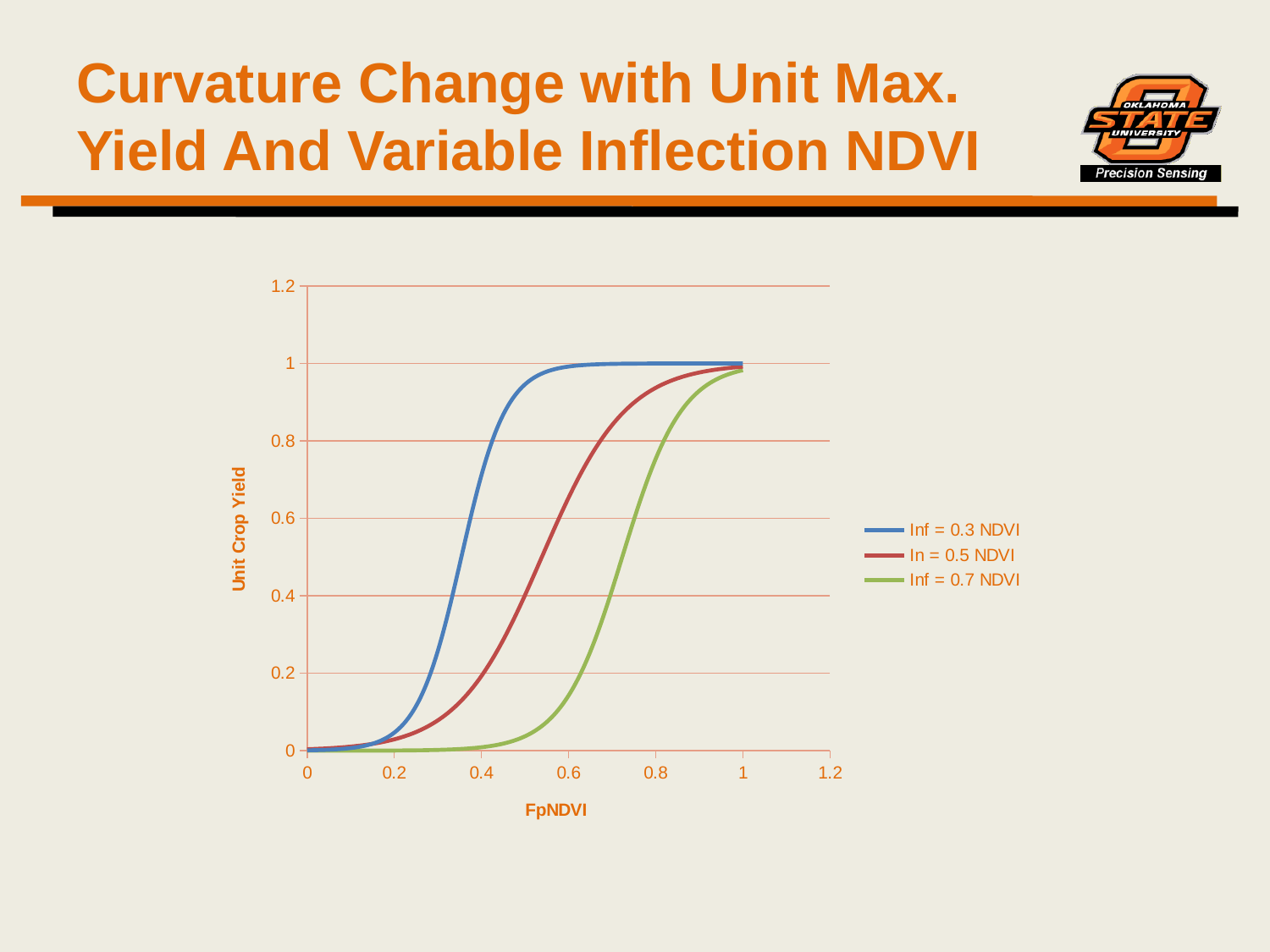
What is the title of the x axis? FpNDVI Is the Unit Crop Yield for the Inf = 0.7 NDVI series at FpNDVI 0.4 greater or less than 0.2? less Which series reaches a Unit Crop Yield of 0.8 at the lowest FpNDVI value? Inf = 0.3 NDVI What is the title of the y axis? Unit Crop Yield Is the Unit Crop Yield for the In = 0.5 NDVI series at FpNDVI 0.4 greater or less than 0.4? less How many series does the legend list? 3 At FpNDVI 0.5, which series has the higher Unit Crop Yield, Inf = 0.3 NDVI or Inf = 0.7 NDVI? Inf = 0.3 NDVI Is the Unit Crop Yield for the Inf = 0.3 NDVI series at FpNDVI 0.4 greater or less than 0.8? less At FpNDVI 0.7, which series has the higher Unit Crop Yield, In = 0.5 NDVI or Inf = 0.7 NDVI? In = 0.5 NDVI Do the values of the Inf = 0.3 NDVI series rise or fall as FpNDVI increases? Rise What kind of chart is shown on the slide? Line chart